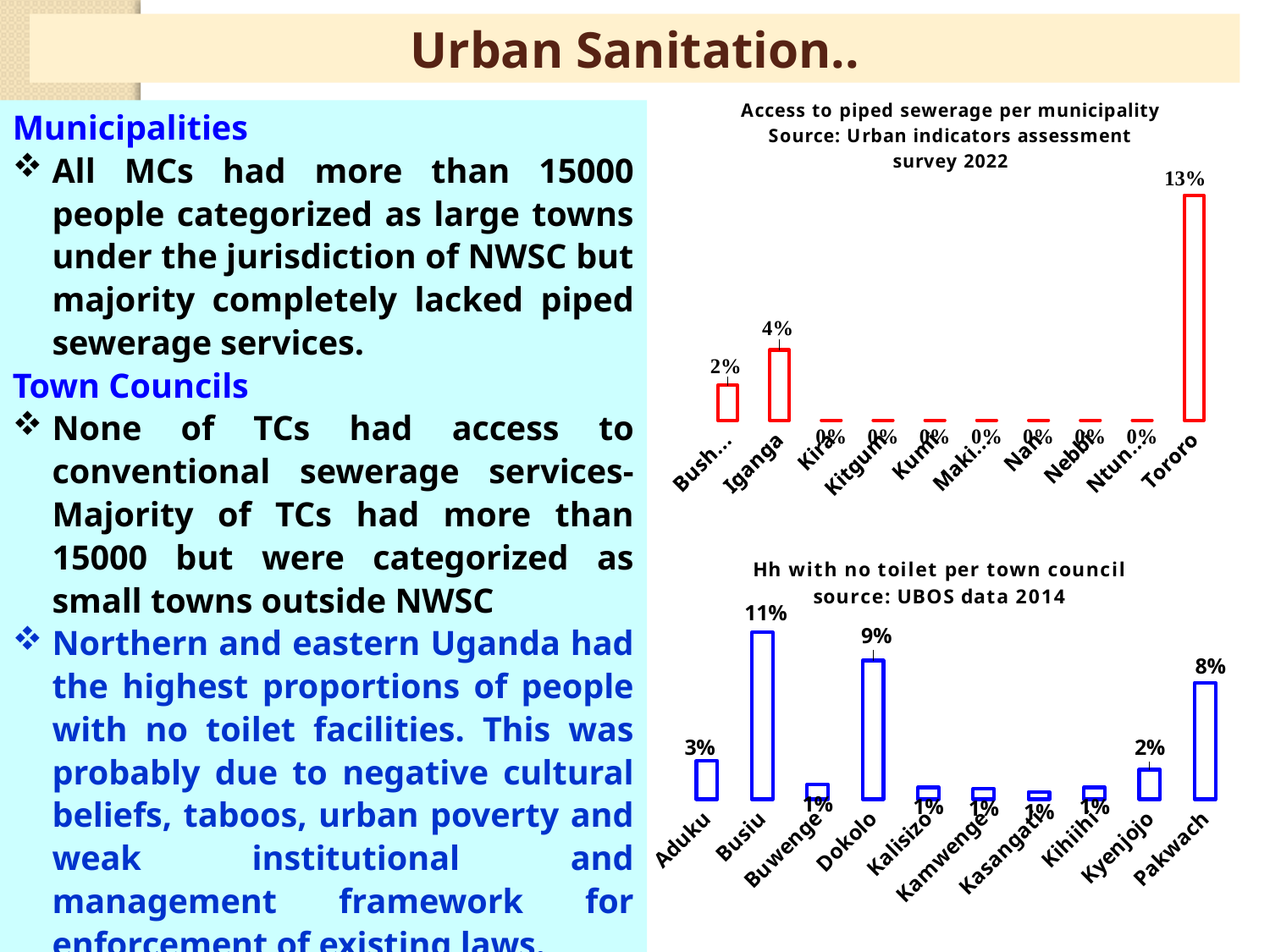
In the 'Access to piped sewerage per municipality' chart, what is the value for Tororo? 13% In the 'Hh with no toilet per town council' chart, what is the difference between Busiu and Dokolo? 2% In the 'Hh with no toilet per town council' chart, what is the value for Busiu? 11% In the 'Hh with no toilet per town council' chart, which is larger, Dokolo or Aduku? Dokolo In the 'Access to piped sewerage per municipality' chart, how many municipalities are shown? 10 In the 'Access to piped sewerage per municipality' chart, what is the value for Iganga? 4% In the 'Access to piped sewerage per municipality' chart, which municipality has the highest value? Tororo In the 'Hh with no toilet per town council' chart, what is the value for Pakwach? 8% In the 'Access to piped sewerage per municipality' chart, what is the value for Kitgum? 0% What type of chart is the 'Hh with no toilet per town council' chart? Bar chart In the 'Access to piped sewerage per municipality' chart, what is the difference between Tororo and Iganga? 9% In the 'Hh with no toilet per town council' chart, which town council has the highest value? Busiu